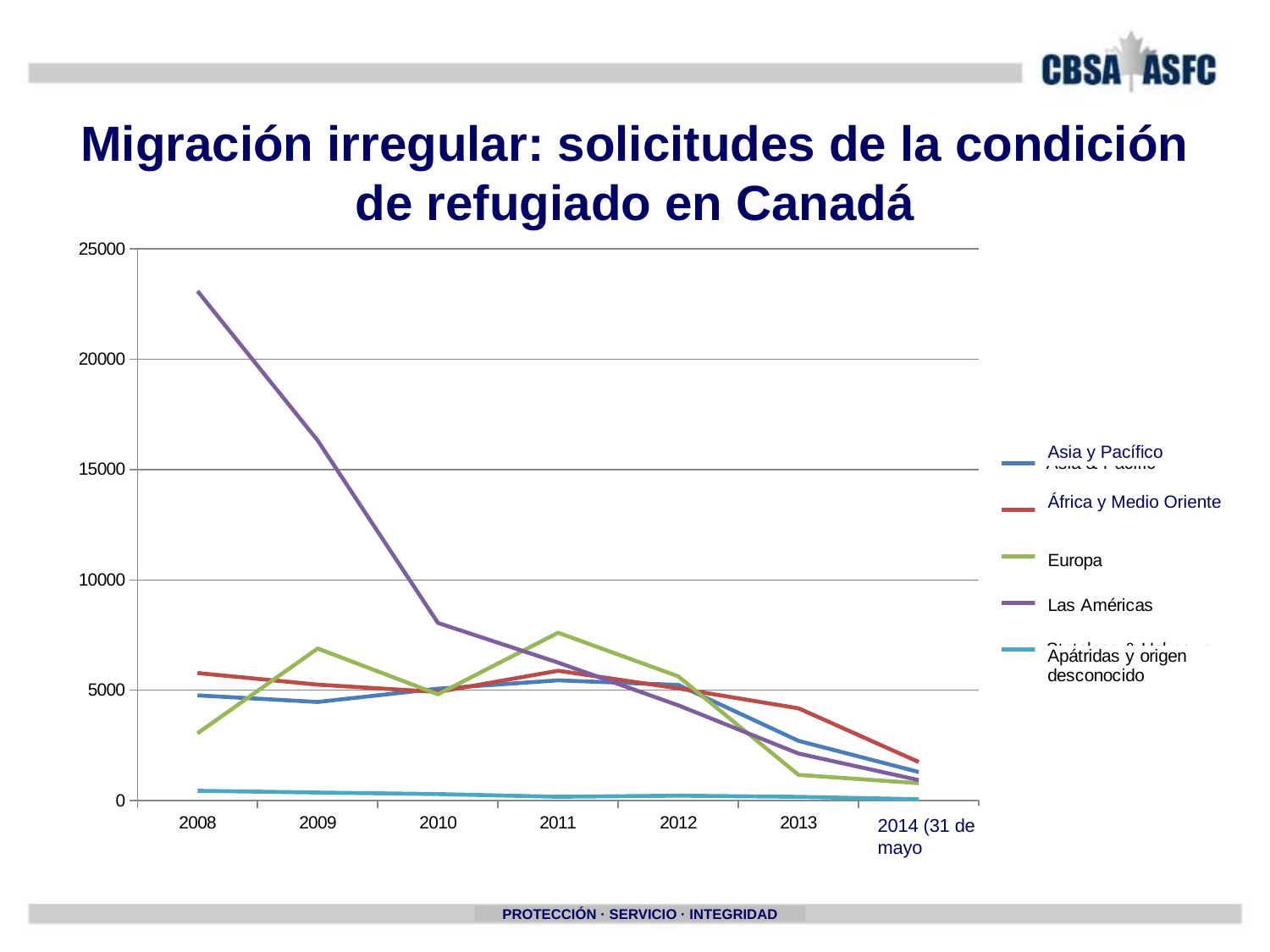
Which series has the lowest value in 2008? Apátridas y origen desconocido What kind of chart is shown on the slide? line chart Which series has the highest value in 2013? África y Medio Oriente Is the value for Europa in 2011 greater or less than 5000? greater Is the value for Las Américas in 2008 greater or less than 20000? greater Does the Las Américas line rise or fall from 2008 to 2014? fall Which series has the highest value in 2008? Las Américas How many series does the legend list? 5 How many years (points) are shown along the x axis? 7 In 2009, which is larger: Europa or Asia y Pacífico? Europa Is the value for Las Américas in 2010 greater or less than 10000? less